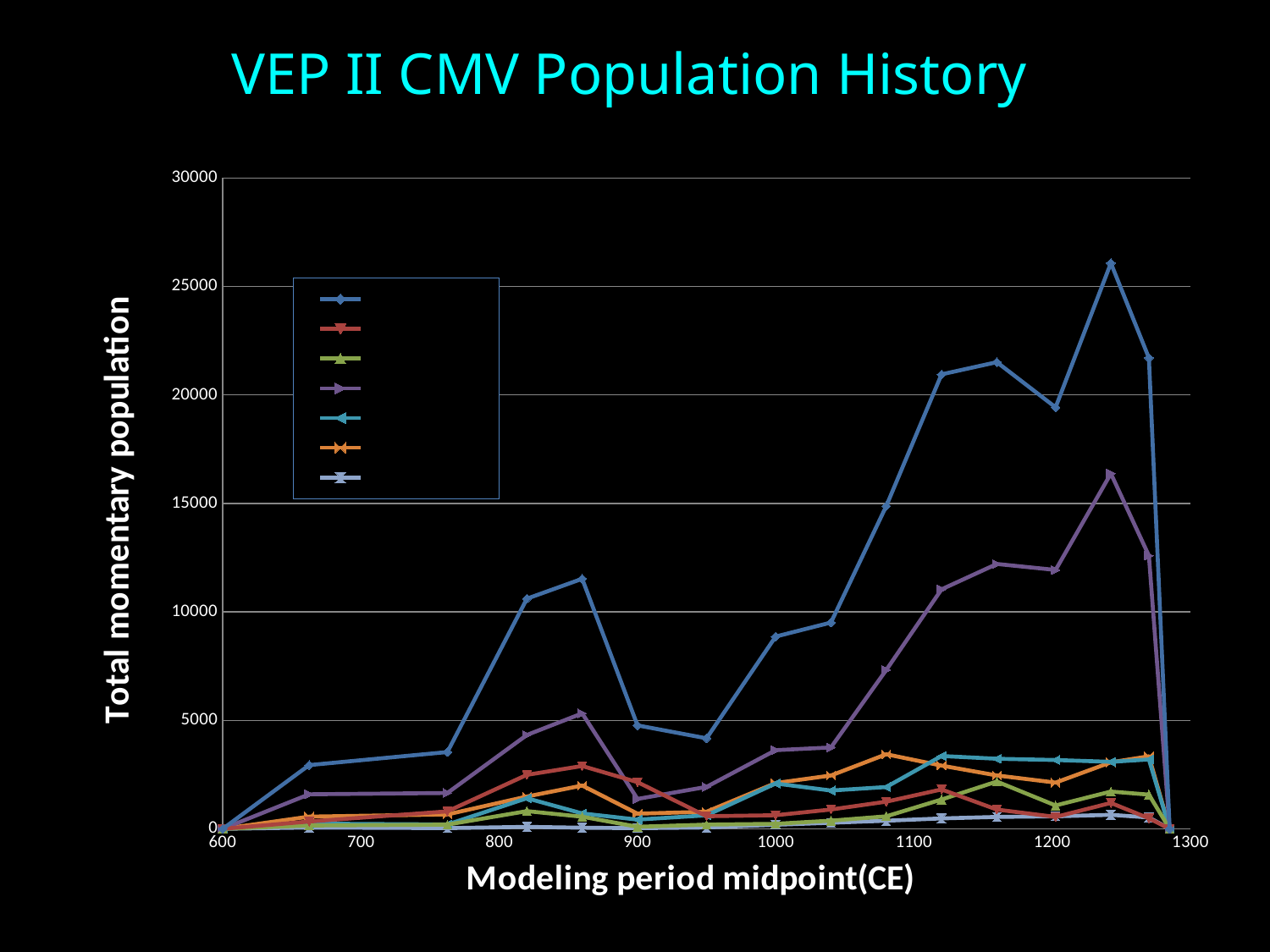
How many series does the legend list? 7 Is the value of the purple series at its peak around 1240 CE greater or less than 15000? greater Is the value of the purple series at about 1120 CE greater or less than 10000? greater What kind of chart is shown on the slide? line chart Does the blue series generally rise or fall between 1000 CE and 1240 CE? rise What is the label of the x axis? Modeling period midpoint(CE) Is the peak value of the blue (top) series, around 1240 CE, greater or less than 25000? greater What is the title of the chart? VEP II CMV Population History Which series reaches the highest value on the chart, the blue series or the purple series? the blue series